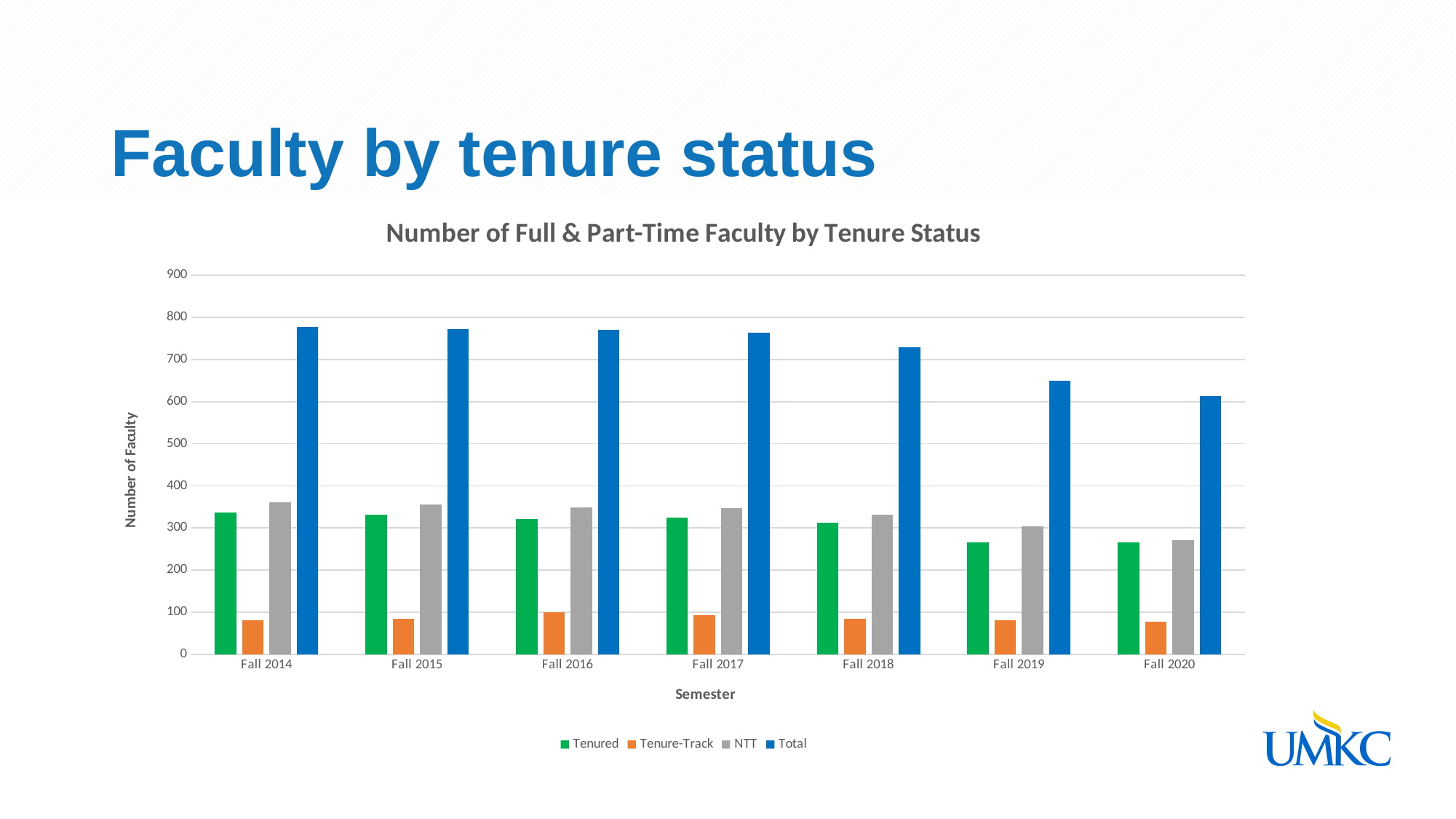
Does the Total value rise or fall from Fall 2014 to Fall 2020? fall Is the Total value for Fall 2014 greater or less than 700? greater Is the Tenure-Track value for Fall 2016 greater or less than 200? less Is the Tenured value for Fall 2019 greater or less than 300? less Which is larger in Fall 2014, the Tenured value or the NTT value? NTT How many semesters are shown on the x axis? 7 How many series does the legend list? 4 What kind of chart is shown on the slide? Bar chart In which semester is the NTT value lowest? Fall 2020 In which semester is the Total value lowest? Fall 2020